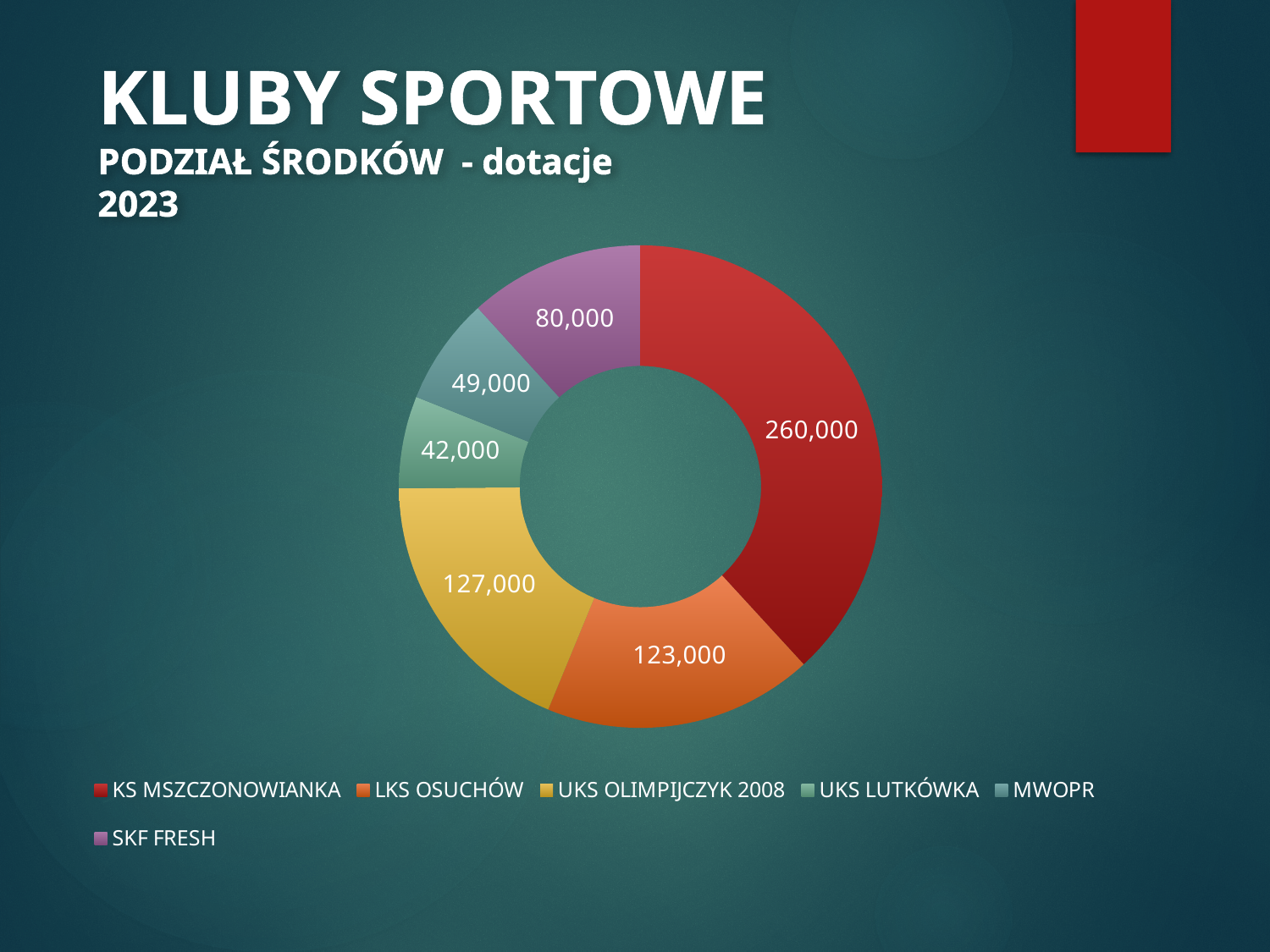
Which club received the largest amount? KS MSZCZONOWIANKA What value is shown for UKS OLIMPIJCZYK 2008? 127,000 What value is shown for KS MSZCZONOWIANKA? 260,000 What is the total of all values shown in the chart? 681,000 How many clubs are shown in the chart? 6 Which is larger, the value for LKS OSUCHÓW or the value for UKS OLIMPIJCZYK 2008? UKS OLIMPIJCZYK 2008 Which club received the smallest amount? UKS LUTKÓWKA What is the difference between the values for KS MSZCZONOWIANKA and LKS OSUCHÓW? 137,000 What kind of chart is shown on the slide? Doughnut chart Which colour represents SKF FRESH in the chart? Purple What value is shown for SKF FRESH? 80,000 What value is shown for MWOPR? 49,000